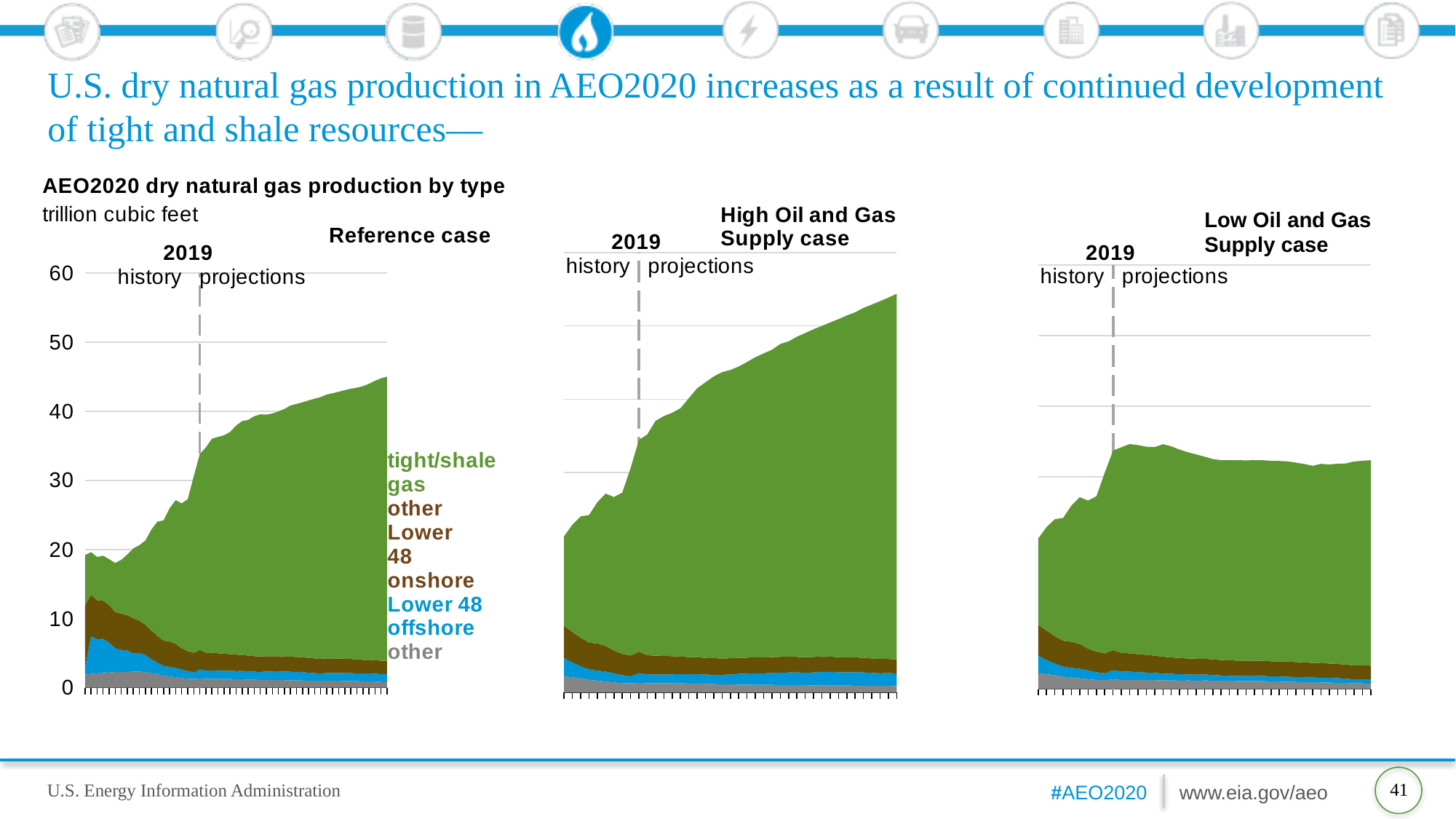
What unit is used on the y-axis of the charts? trillion cubic feet In the High Oil and Gas Supply case chart, do total production values rise or fall over the projection period? rise In the High Oil and Gas Supply case chart, is total production at the end of the projection period greater or less than 50 trillion cubic feet? greater How many production types does the legend list? 4 Which case shows the highest total production at the end of the projection period? High Oil and Gas Supply case In the Low Oil and Gas Supply case chart, is total production at the end of the projection period greater or less than 40 trillion cubic feet? less Which case shows the lowest total production at the end of the projection period? Low Oil and Gas Supply case How many charts (cases) are shown on the slide? 3 What kind of chart is used for the Reference case panel? area chart In the Reference case chart, is total dry natural gas production at the end of the projection period greater or less than 40 trillion cubic feet? greater In the Reference case chart, which production type makes up the largest share of production at the end of the projection period? tight/shale gas